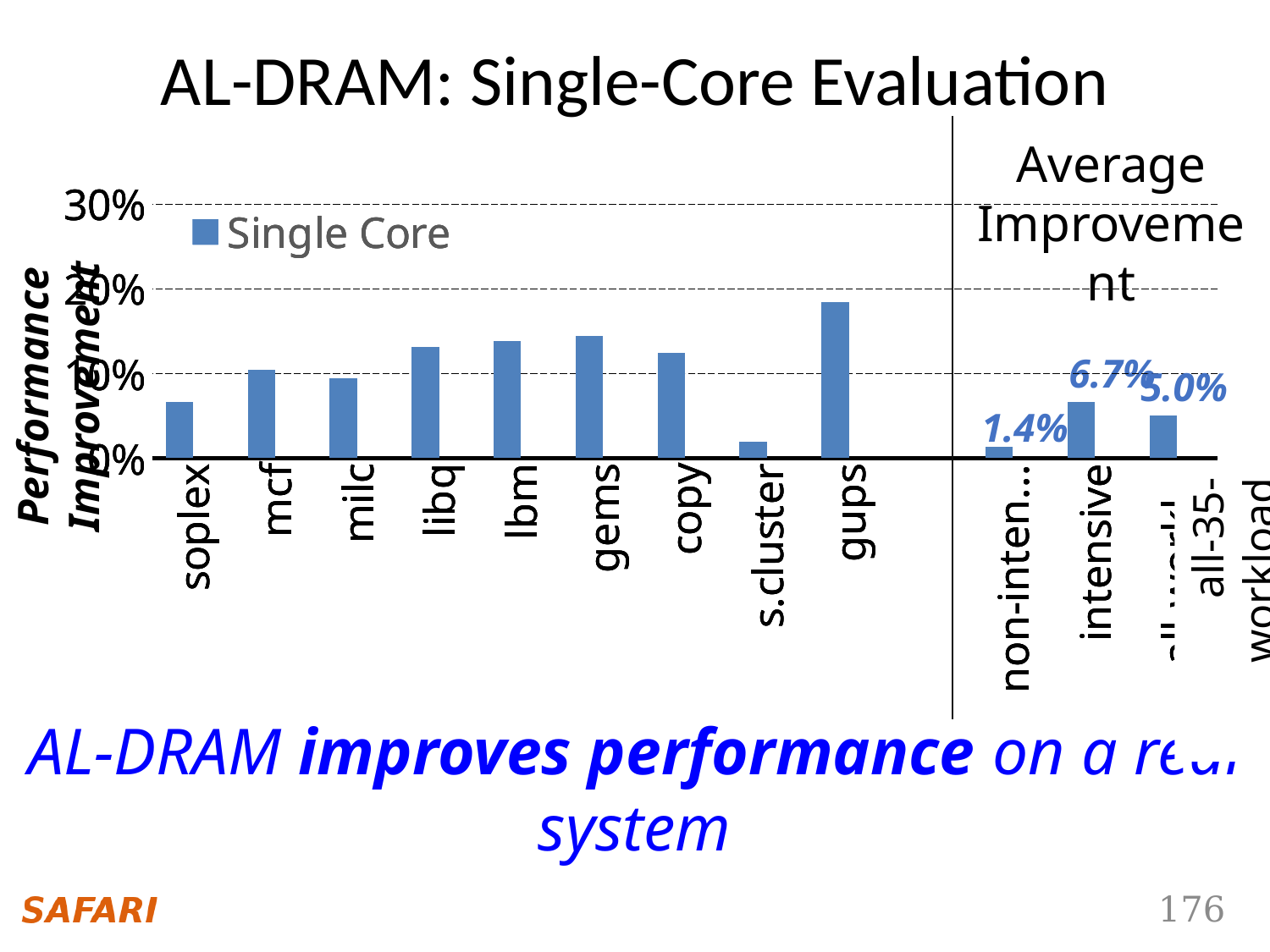
What is the legend entry for the series shown in the chart? Single Core Is the performance improvement for gups greater or less than 10%? greater What kind of chart is shown on the slide? bar chart What is the difference between the average improvement for intensive and non-intensive workloads? 5.3% What is the average performance improvement across all 35 workloads? 5.0% How many series does the legend list? 1 Is the performance improvement for soplex greater or less than 10%? less Which individual benchmark (left of the divider) has the lowest performance improvement? s.cluster Which has a larger average improvement, intensive or non-intensive workloads? intensive What is the average performance improvement for the non-intensive workloads? 1.4% What is the average performance improvement for the intensive workloads? 6.7% Which individual benchmark (left of the divider) has the highest performance improvement? gups